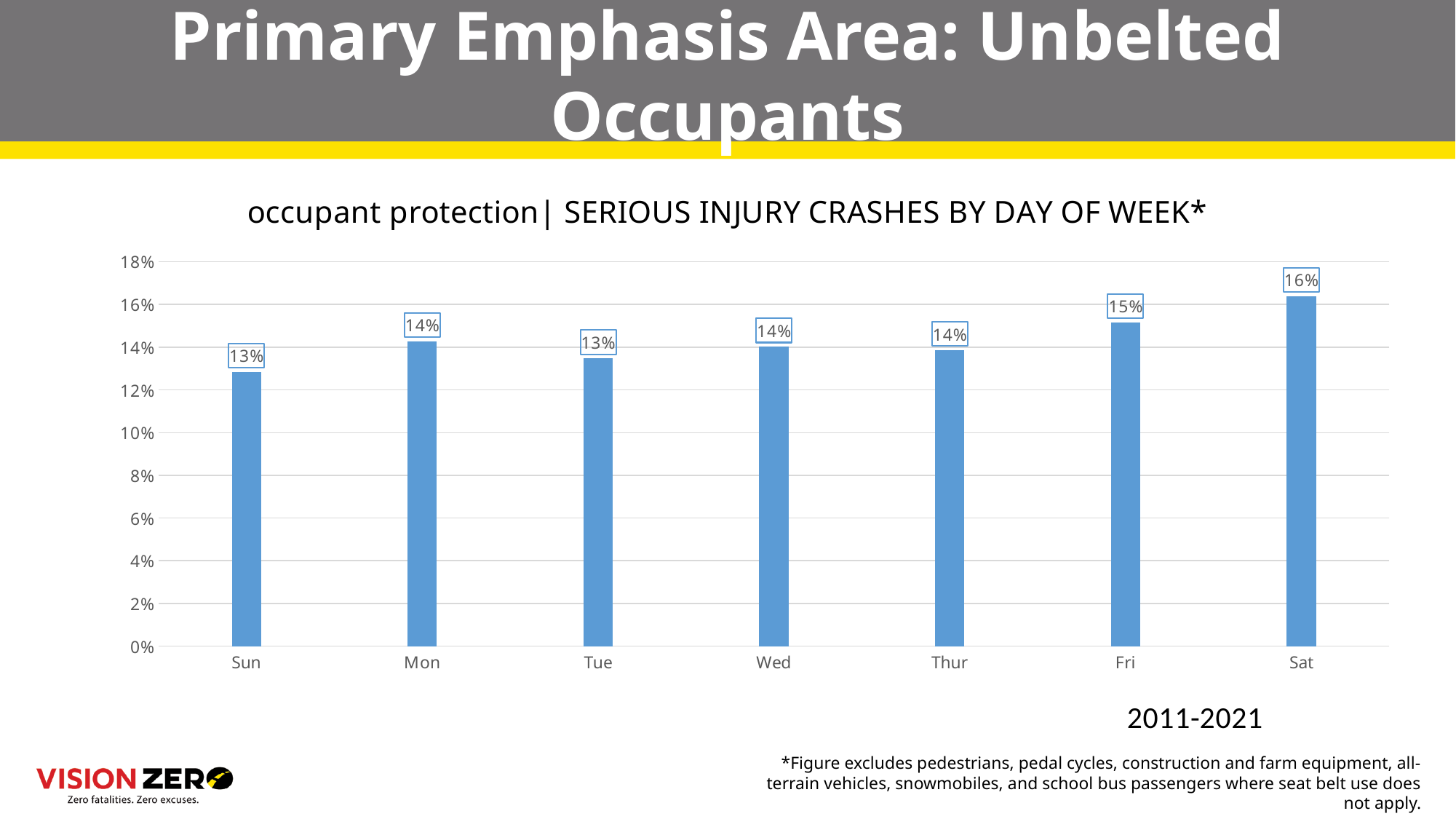
What is the value for Sat? 16% How many days of the week are shown on the x axis? 7 Is the value for Sat greater or less than 14%? greater Do the values rise or fall from Thur to Sat? rise What is the value for Wed? 14% What is the value for Fri? 15% Which day of the week has the highest value? Sat What time period is shown below the chart? 2011-2021 What is the value for Sun? 13% Which is larger, the value for Fri or the value for Mon? Fri What kind of chart is shown on the slide? bar chart What is the difference between the values for Sat and Sun? 3 percentage points